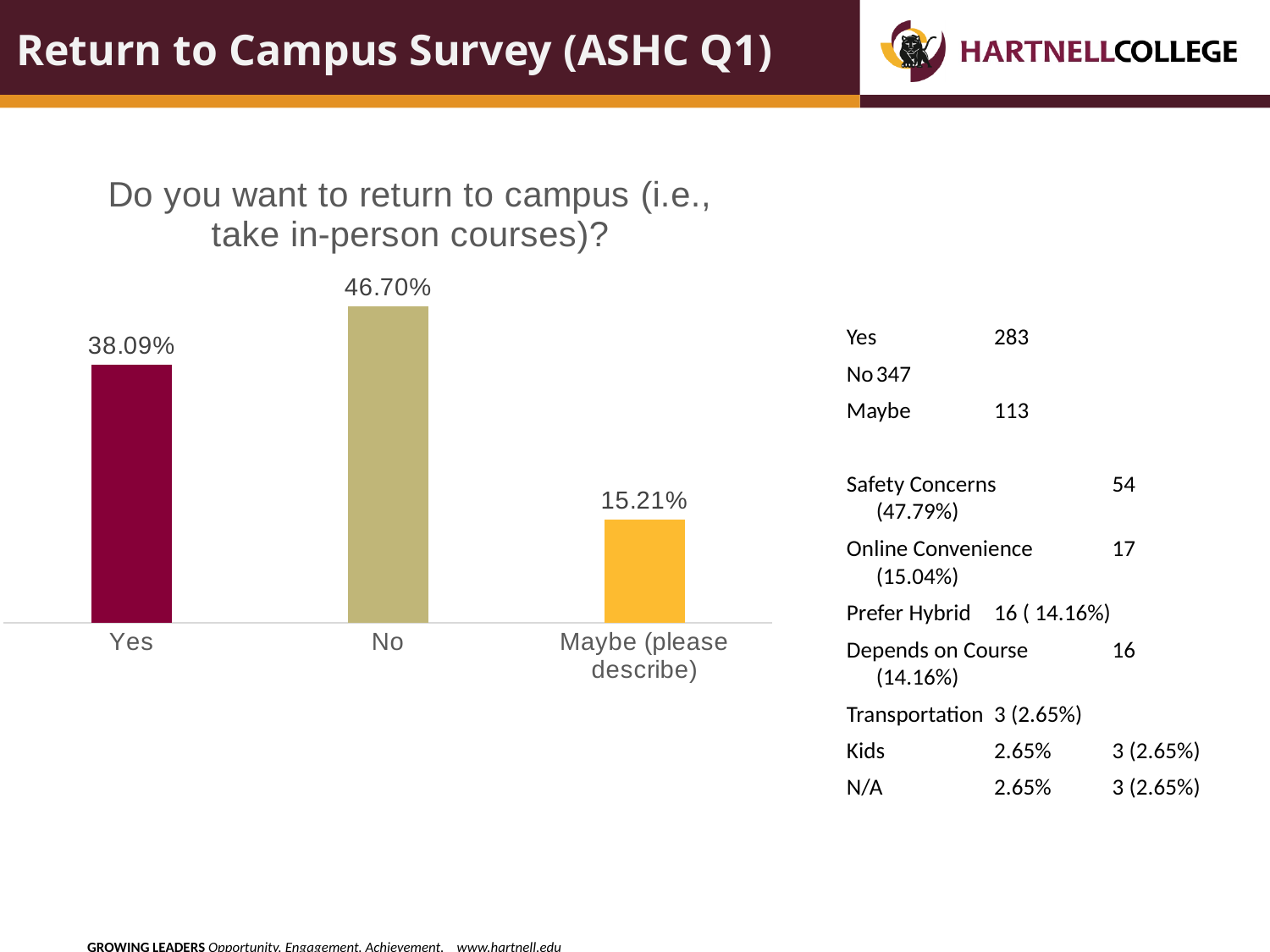
Which category has the lowest value? Maybe (please describe) What is the value for No? 46.70% Which category has the highest value? No Which is larger, the value for Yes or the value for No? No What kind of chart is shown on the slide? Bar chart What colour is the bar for Yes? Dark red What is the difference between the values for No and Yes? 8.61% What is the difference between the values for Yes and Maybe (please describe)? 22.88% What is the title of the chart? Do you want to return to campus (i.e., take in-person courses)? How many categories are shown in the chart? 3 What is the value for Yes? 38.09% What is the value for Maybe (please describe)? 15.21%